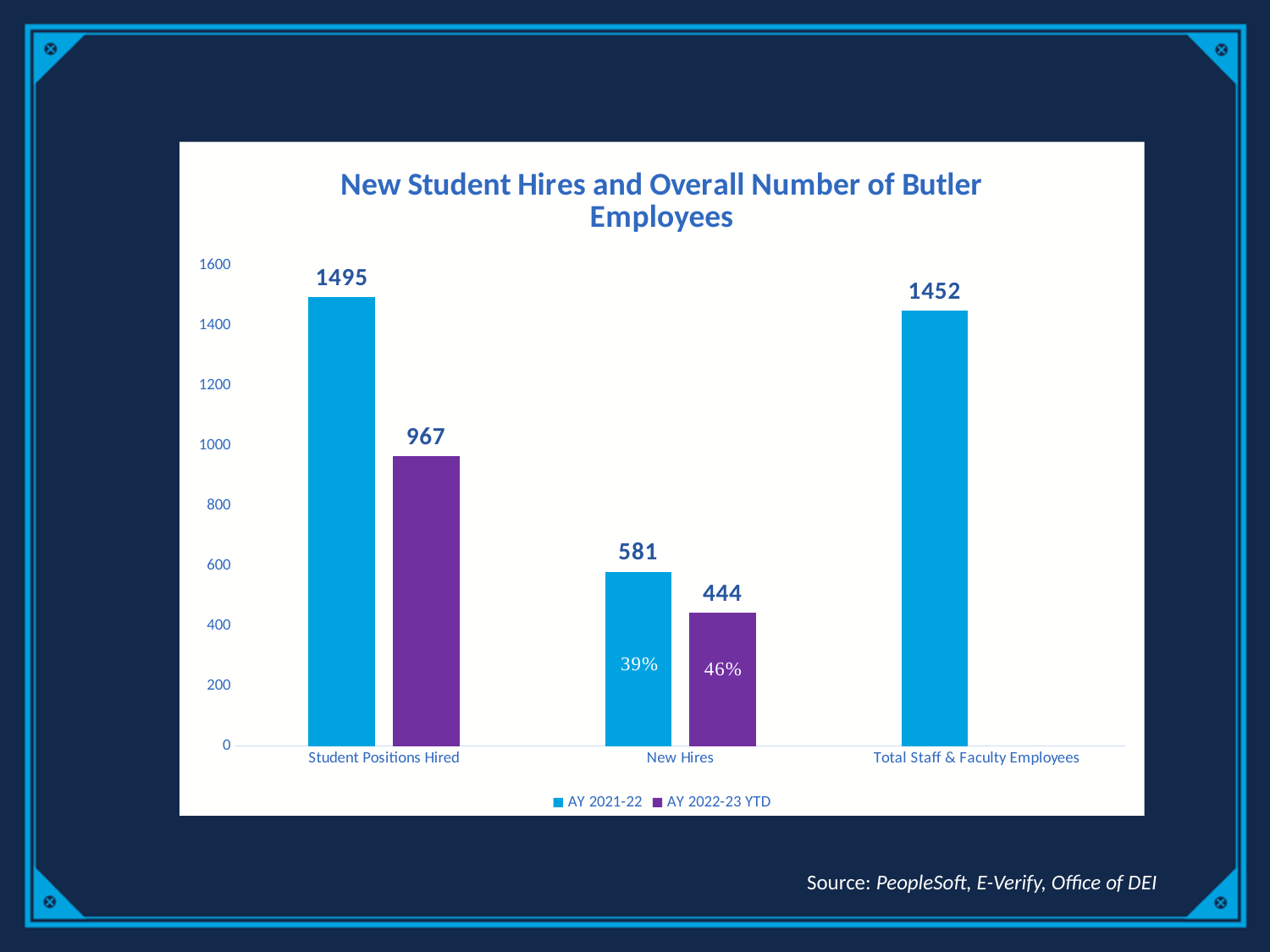
What is the value for New Hires in AY 2021-22? 581 Which category has the lowest AY 2022-23 YTD value? New Hires What kind of chart is shown on the slide? Bar chart What is the value for Total Staff & Faculty Employees in AY 2021-22? 1452 What is the difference between the AY 2021-22 and AY 2022-23 YTD values for Student Positions Hired? 528 What is the value for New Hires in AY 2022-23 YTD? 444 Which is larger: New Hires in AY 2021-22 or New Hires in AY 2022-23 YTD? AY 2021-22 What percentage label is shown on the AY 2022-23 YTD bar for New Hires? 46% What is the value for Student Positions Hired in AY 2022-23 YTD? 967 Which category has the highest AY 2021-22 value? Student Positions Hired How many series does the legend list? 2 What is the value for Student Positions Hired in AY 2021-22? 1495